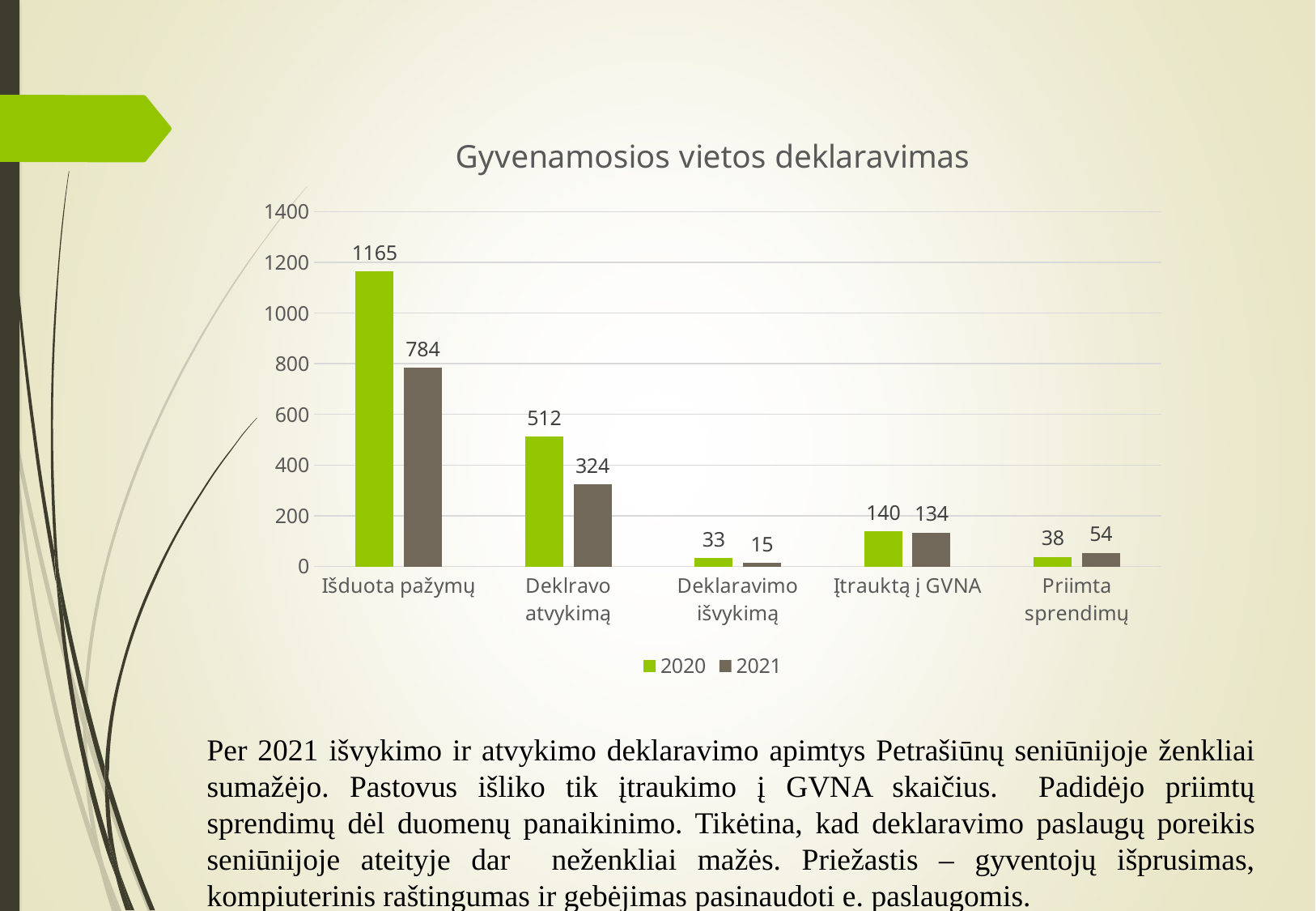
What kind of chart is shown on the slide? bar chart Which category has the highest value in the 2020 series? Išduota pažymų Is the 2021 value for Išduota pažymų greater or less than 800? less What is the value for Priimta sprendimų in 2021? 54 What is the value for Išduota pažymų in 2020? 1165 What is the value for Deklaravimo išvykimą in 2021? 15 What is the title of the chart? Gyvenamosios vietos deklaravimas Which is larger for Priimta sprendimų, the 2020 value or the 2021 value? 2021 Which category has the lowest value in the 2021 series? Deklaravimo išvykimą How many categories are shown on the x axis? 5 How many series does the legend list? 2 What is the difference between the 2020 and 2021 values for Deklravo atvykimą? 188